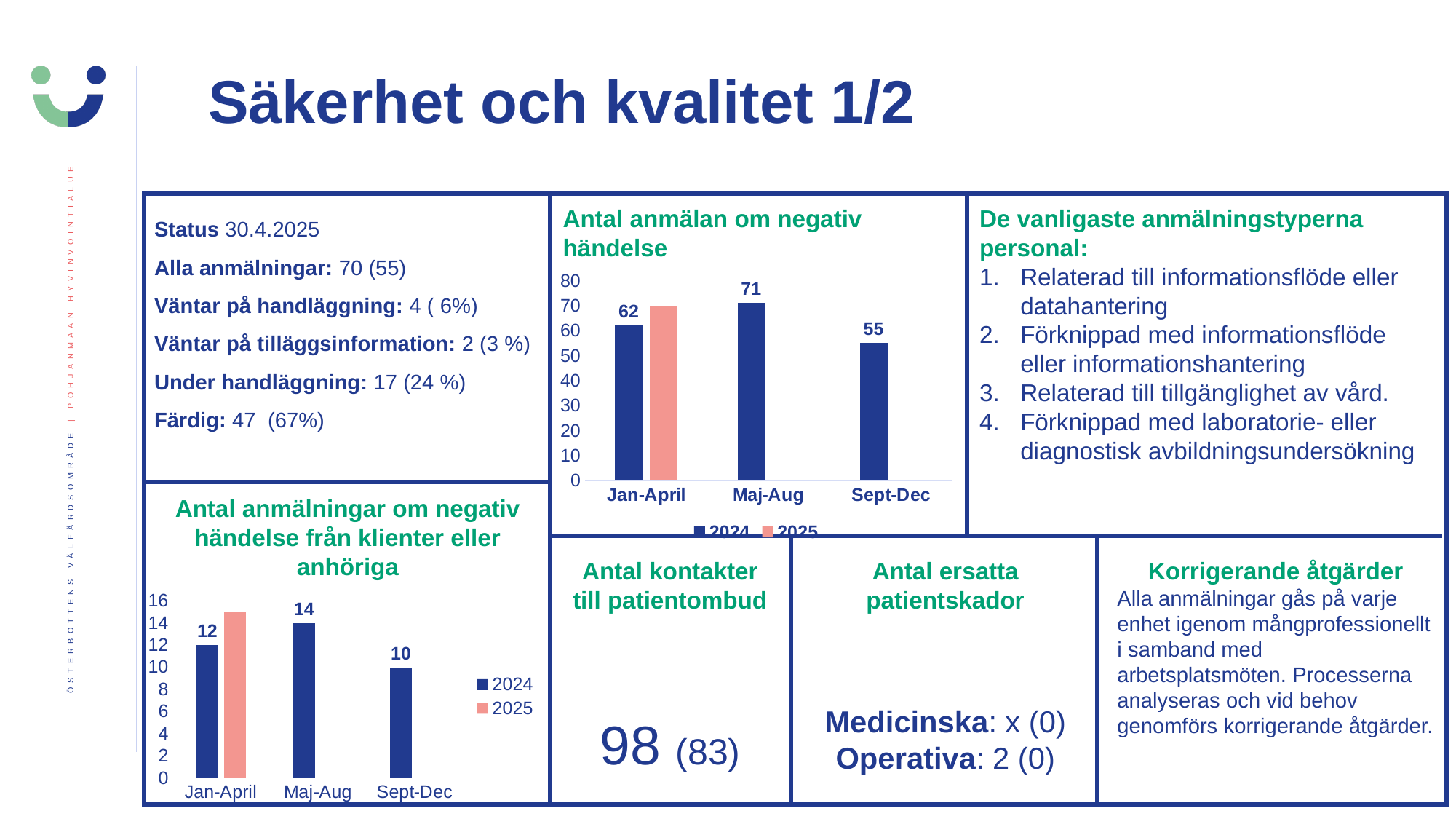
In the chart 'Antal anmälan om negativ händelse', what is the difference between the 2024 values for Maj-Aug and Sept-Dec? 16 In the chart 'Antal anmälan om negativ händelse', what is the 2024 value for Sept-Dec? 55 In the chart 'Antal anmälningar om negativ händelse från klienter eller anhöriga', is the 2025 value for Jan-April greater or less than 10? greater In the chart 'Antal anmälningar om negativ händelse från klienter eller anhöriga', how many periods are shown on the x axis? 3 In the chart 'Antal anmälningar om negativ händelse från klienter eller anhöriga', which period has the lowest 2024 value? Sept-Dec In the chart 'Antal anmälningar om negativ händelse från klienter eller anhöriga', what is the 2024 value for Jan-April? 12 In the chart 'Antal anmälningar om negativ händelse från klienter eller anhöriga', is the 2024 value for Maj-Aug larger than the 2024 value for Jan-April? Yes In the chart 'Antal anmälan om negativ händelse', which period has the highest 2024 value? Maj-Aug In the chart 'Antal anmälan om negativ händelse', how many series does the legend list? 2 In the chart 'Antal anmälan om negativ händelse', what is the 2024 value for Maj-Aug? 71 What type of chart is 'Antal anmälningar om negativ händelse från klienter eller anhöriga'? Bar chart In the chart 'Antal anmälan om negativ händelse', is the 2025 value for Jan-April greater or less than 60? greater